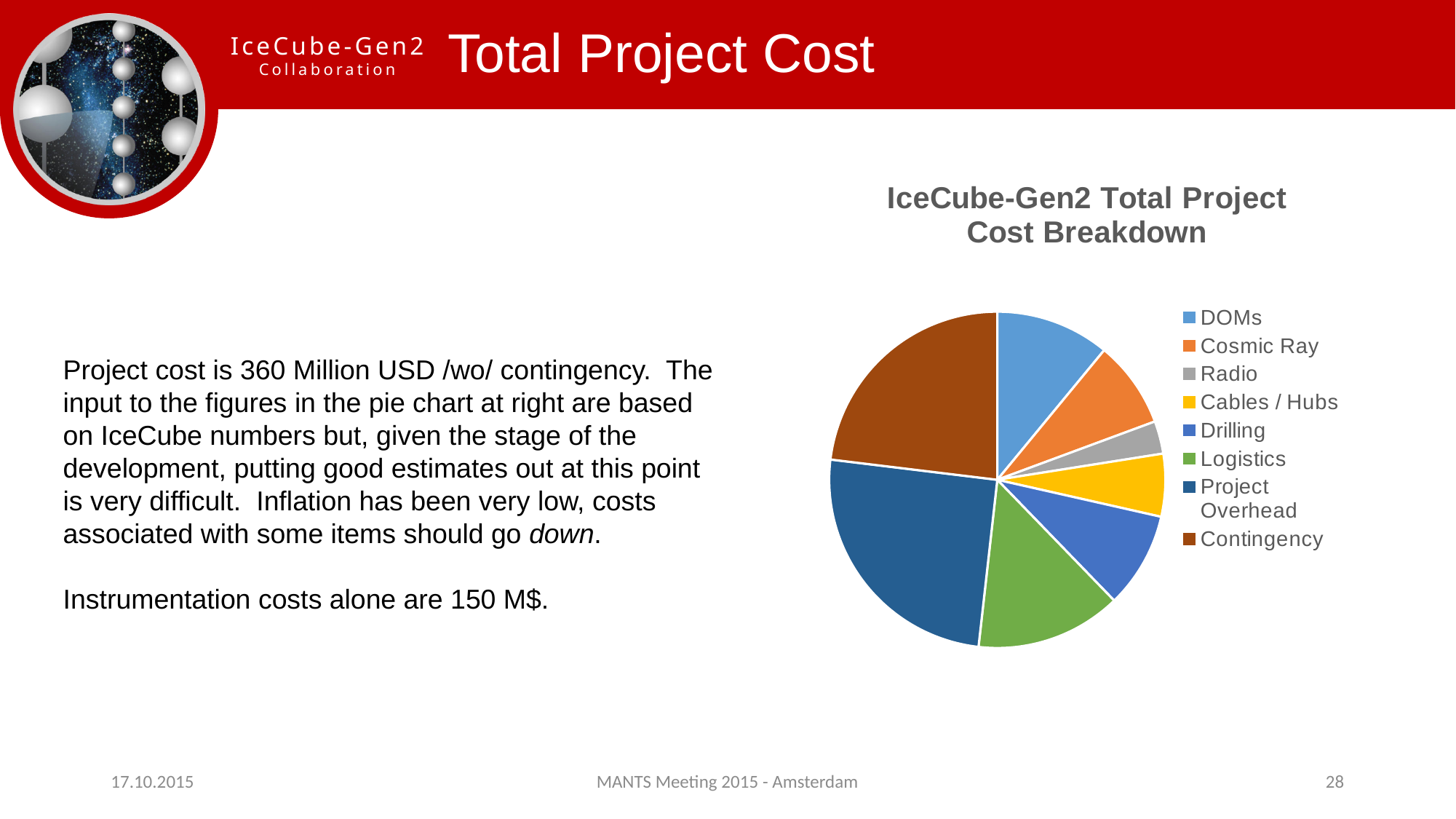
What colour is the Contingency slice in the pie chart? brown How many categories does the pie chart show? 8 What kind of chart is shown on the slide? pie chart Which slice is larger, Cosmic Ray or Radio? Cosmic Ray Which slice is larger, DOMs or Radio? DOMs Which category has the smallest slice in the pie chart? Radio Which slice is larger, Contingency or DOMs? Contingency What is the title of the pie chart? IceCube-Gen2 Total Project Cost Breakdown